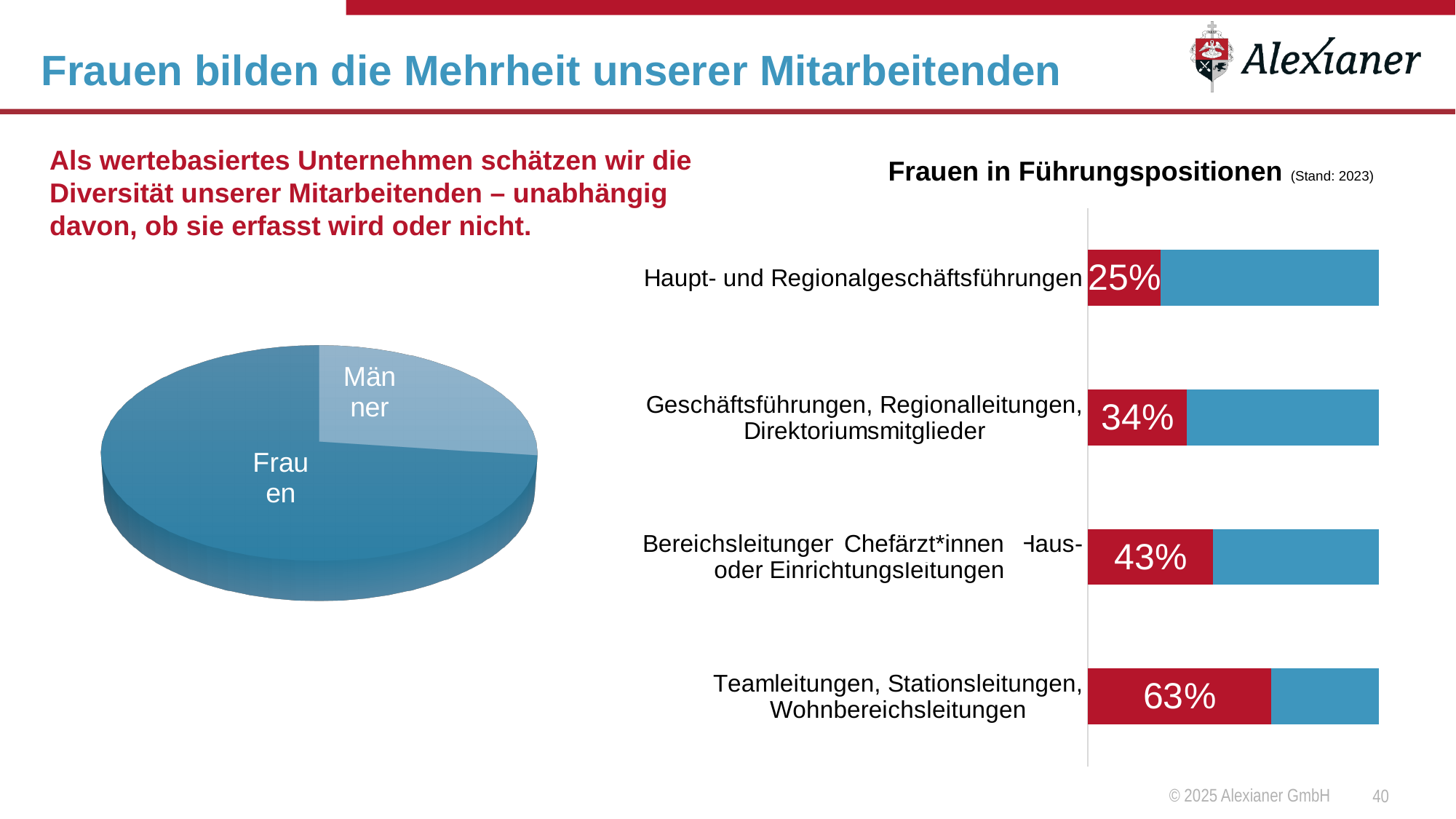
In the 'Frauen in Führungspositionen' chart, which category has the highest value? Teamleitungen, Stationsleitungen, Wohnbereichsleitungen In the 'Frauen in Führungspositionen' chart, what is the value for Haupt- und Regionalgeschäftsführungen? 25% In the 'Frauen in Führungspositionen' chart, which is larger: the value for Geschäftsführungen, Regionalleitungen, Direktoriumsmitglieder or the value for Bereichsleitungen, Chefärzt*innen, Haus- oder Einrichtungsleitungen? Bereichsleitungen, Chefärzt*innen, Haus- oder Einrichtungsleitungen In the 'Frauen in Führungspositionen' chart, do the values rise or fall from the top category to the bottom category? Rise In the pie chart on the left, which slice is larger: Frauen or Männer? Frauen How many categories does the 'Frauen in Führungspositionen' chart show? 4 In the 'Frauen in Führungspositionen' chart, what is the value for Geschäftsführungen, Regionalleitungen, Direktoriumsmitglieder? 34% What kind of chart is the 'Frauen in Führungspositionen' chart? Bar chart In the 'Frauen in Führungspositionen' chart, what is the value for Teamleitungen, Stationsleitungen, Wohnbereichsleitungen? 63% What kind of chart is the chart on the left side of the slide? Pie chart In the 'Frauen in Führungspositionen' chart, what is the difference between the value for Teamleitungen, Stationsleitungen, Wohnbereichsleitungen and the value for Haupt- und Regionalgeschäftsführungen? 38% In the 'Frauen in Führungspositionen' chart, which category has the lowest value? Haupt- und Regionalgeschäftsführungen